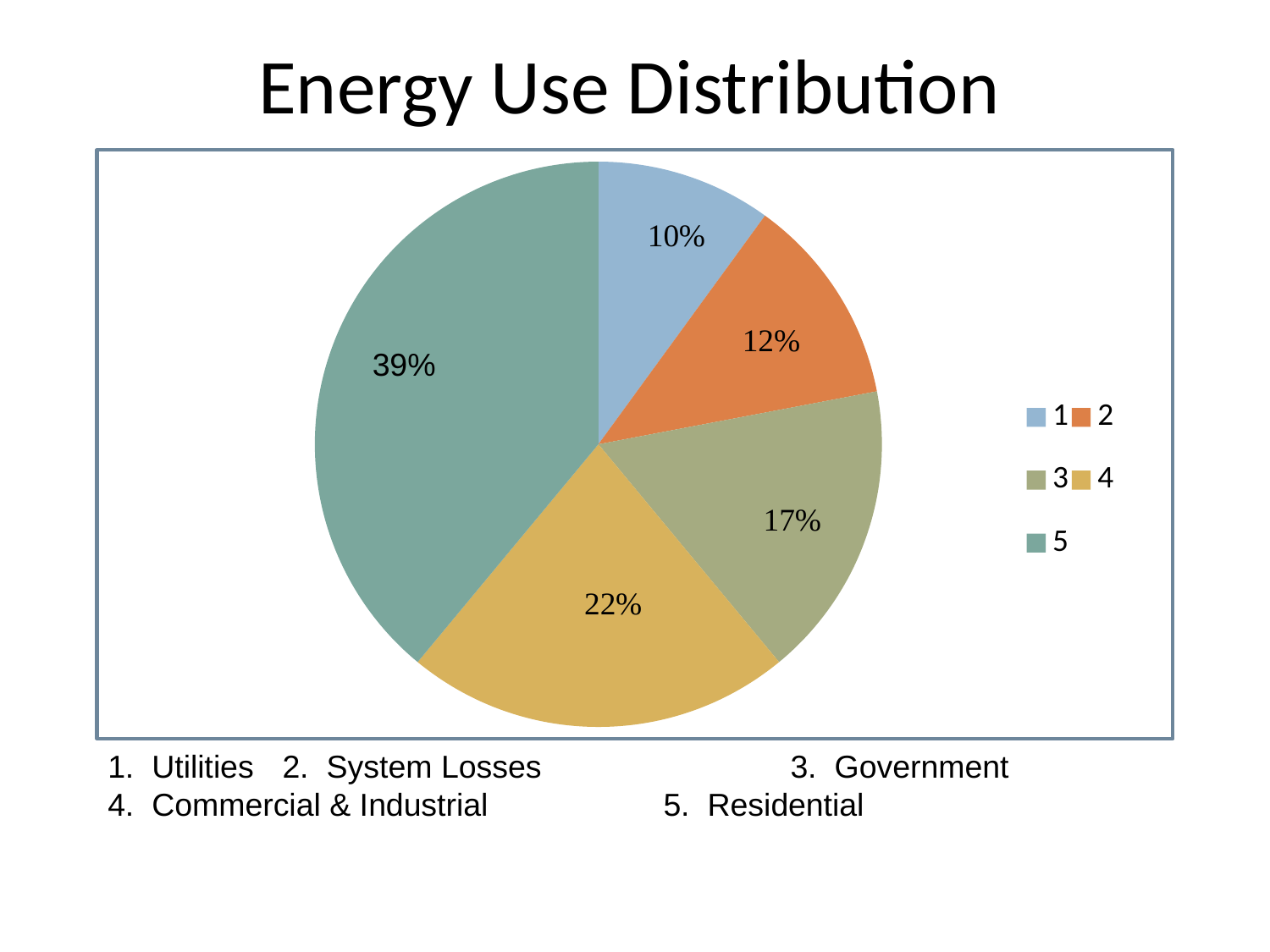
What percentage of energy use is attributed to category 1 (Utilities)? 10% What percentage of energy use is attributed to category 2 (System Losses)? 12% How many slices does the pie chart have? 5 What percentage of energy use is attributed to category 3 (Government)? 17% What kind of chart is shown on the slide? Pie chart What percentage of energy use is attributed to category 4 (Commercial & Industrial)? 22% Which is larger, the share for Government or the share for System Losses? Government What percentage of energy use is attributed to category 5 (Residential)? 39% Which category has the largest share of the pie? 5 (Residential) What is the title of the slide containing the chart? Energy Use Distribution What is the difference in percentage points between the Residential share and the Commercial & Industrial share? 17 Which category has the smallest share of the pie? 1 (Utilities)